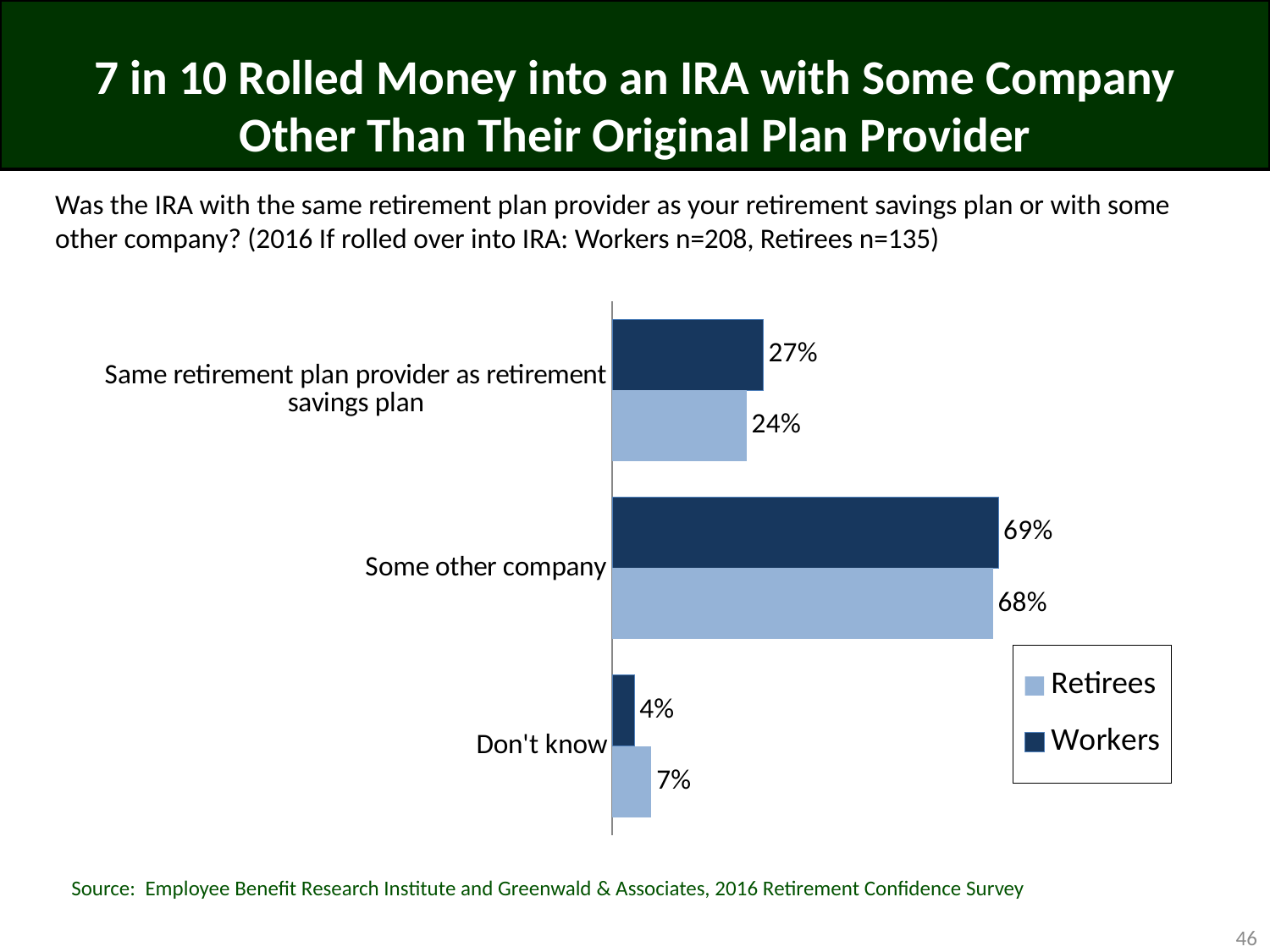
What percentage of Retirees said the IRA was with the same retirement plan provider as their retirement savings plan? 24% How many series does the legend list? 2 What kind of chart is shown on the slide? Bar chart What percentage of Retirees answered "Don't know"? 7% What percentage of Workers answered "Don't know"? 4% What is the difference between the Workers and Retirees values for "Same retirement plan provider as retirement savings plan"? 3 percentage points What percentage of Workers said the IRA was with some other company? 69% Which category has the highest value for Workers? Some other company Which category has the lowest value for Retirees? Don't know How many categories are shown on the chart? 3 For "Don't know", which group has the larger value, Workers or Retirees? Retirees What is the difference between the Retirees and Workers values for "Don't know"? 3 percentage points